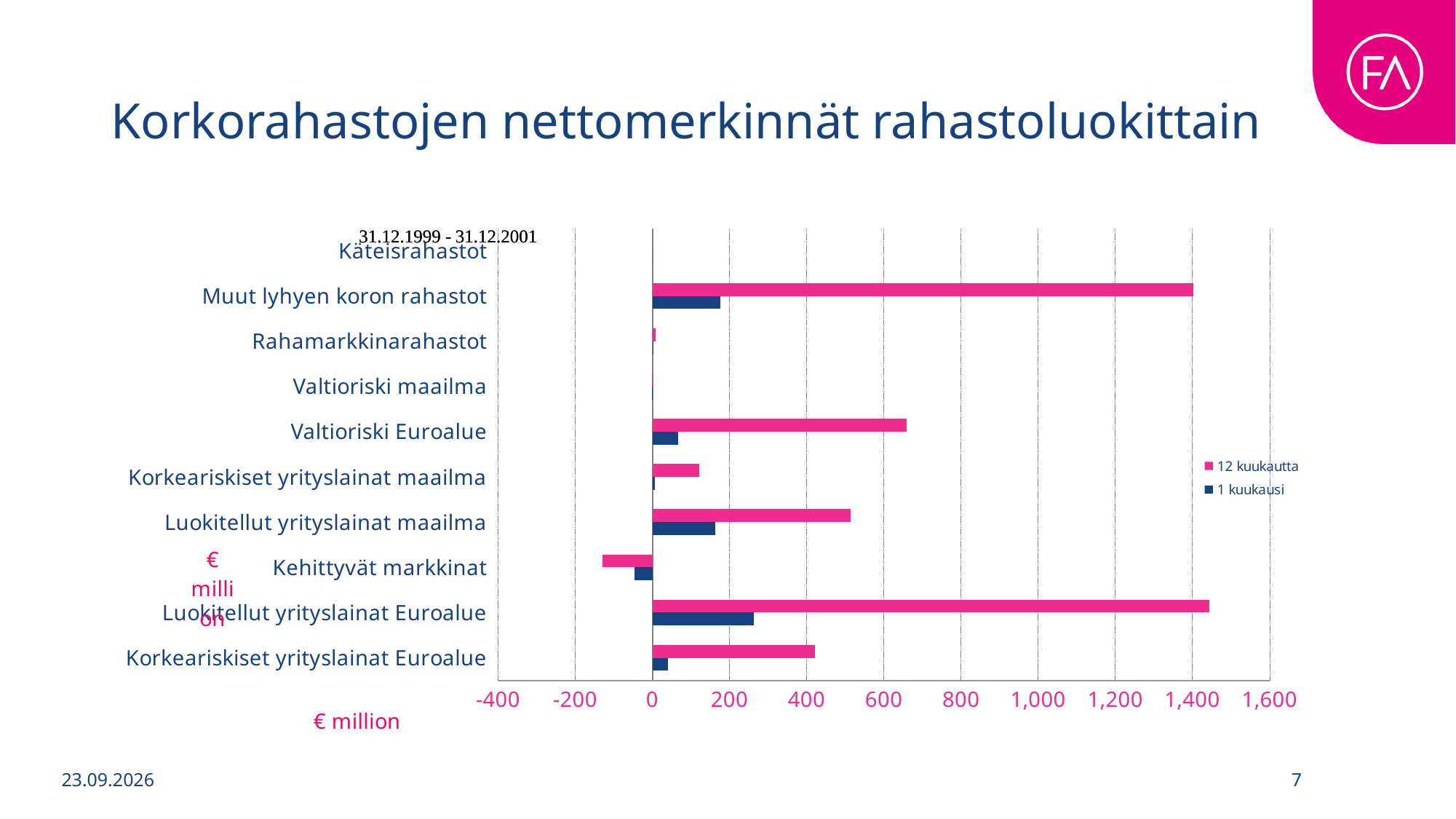
What kind of chart is shown on the slide? bar chart Is the 12 kuukautta value for Valtioriski Euroalue greater or less than 600? greater Is the 12 kuukautta value for Muut lyhyen koron rahastot greater or less than 1,200? greater How many series does the legend list? 2 What unit is shown for the horizontal axis? € million Is the 12 kuukautta value for Korkeariskiset yrityslainat Euroalue greater or less than 200? greater Which category has the lowest value for the 12 kuukautta series? Kehittyvät markkinat Which category has the highest value for the 1 kuukausi series? Luokitellut yrityslainat Euroalue For the 12 kuukautta series, which is larger: Valtioriski Euroalue or Luokitellut yrityslainat maailma? Valtioriski Euroalue How many fund categories are listed on the vertical axis? 10 For the 1 kuukausi series, which is larger: Luokitellut yrityslainat Euroalue or Muut lyhyen koron rahastot? Luokitellut yrityslainat Euroalue